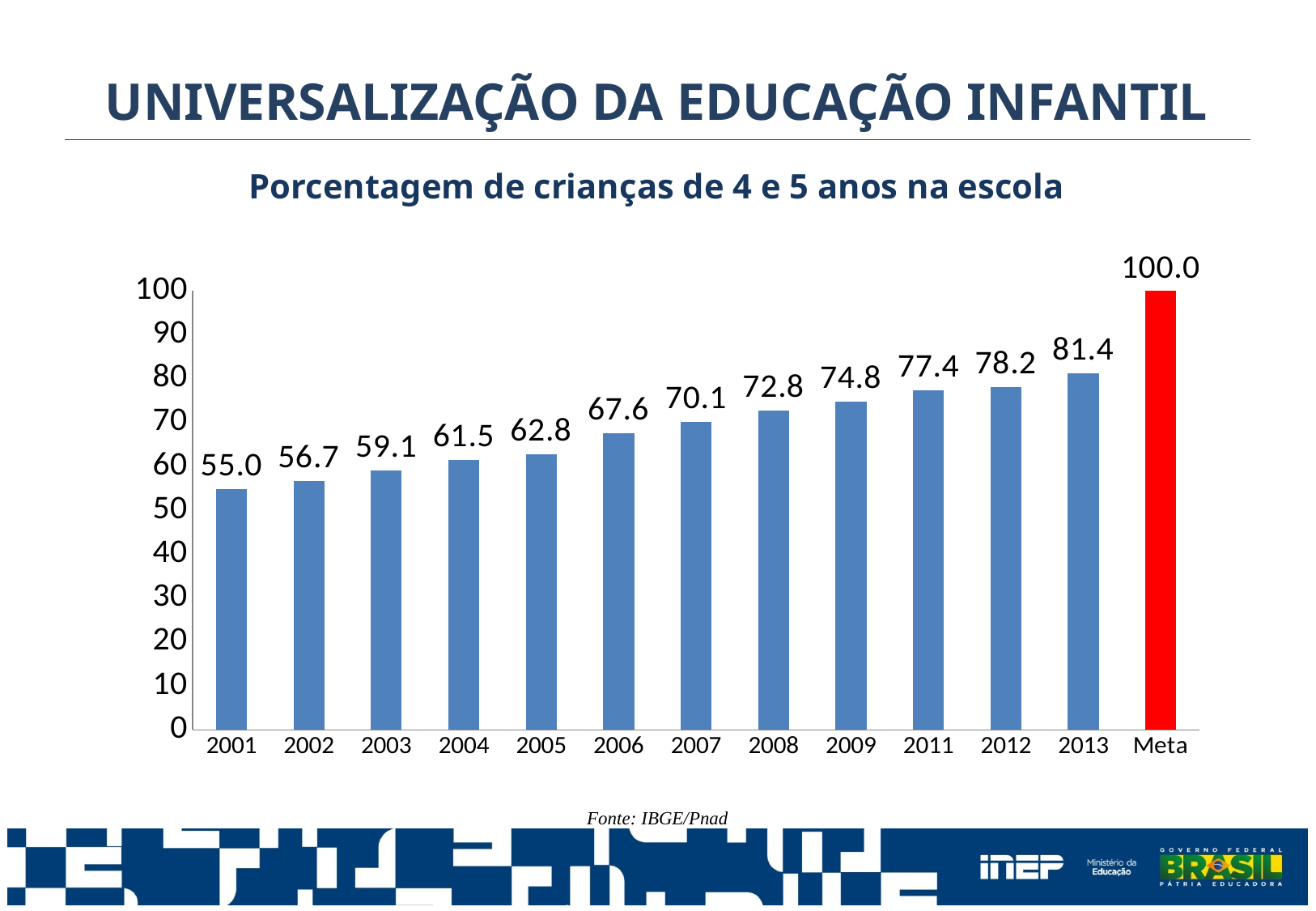
What is the value for 2013? 81.4 Which category has the highest value? Meta What is the value for 2001? 55.0 Do the values rise or fall from 2001 to 2013? Rise Which is larger, the value for 2009 or the value for 2006? 2009 What is the difference between the values for 2013 and 2001? 26.4 What is the value for 2007? 70.1 What is the difference between the Meta value and the 2013 value? 18.6 What kind of chart is this? Bar chart How many categories are shown on the x axis? 13 Which category has the lowest value? 2001 What is the value for Meta? 100.0